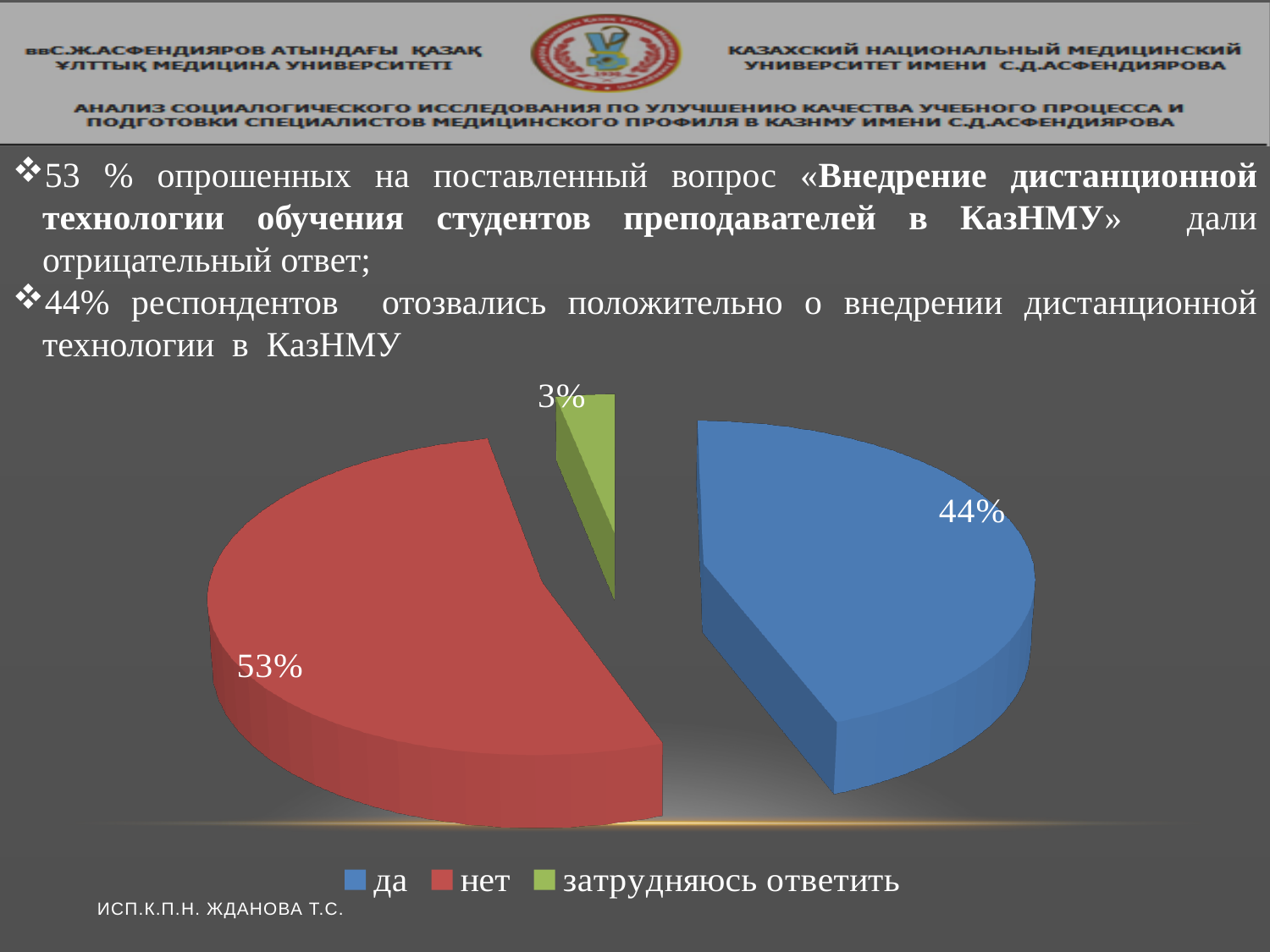
How many categories does the pie chart have? 3 Which category has the largest slice of the pie? нет What share of the pie does the "нет" slice represent? 53% What kind of chart is shown on the slide? pie chart What colour is the "нет" slice? red What colour is the "да" slice? blue How many entries does the legend list? 3 Which category has the smallest slice of the pie? затрудняюсь ответить What share of the pie does the "да" slice represent? 44% What is the difference in percentage points between the "нет" and "да" slices? 9 Which is larger, the "да" slice or the "нет" slice? нет What share of the pie does the "затрудняюсь ответить" slice represent? 3%